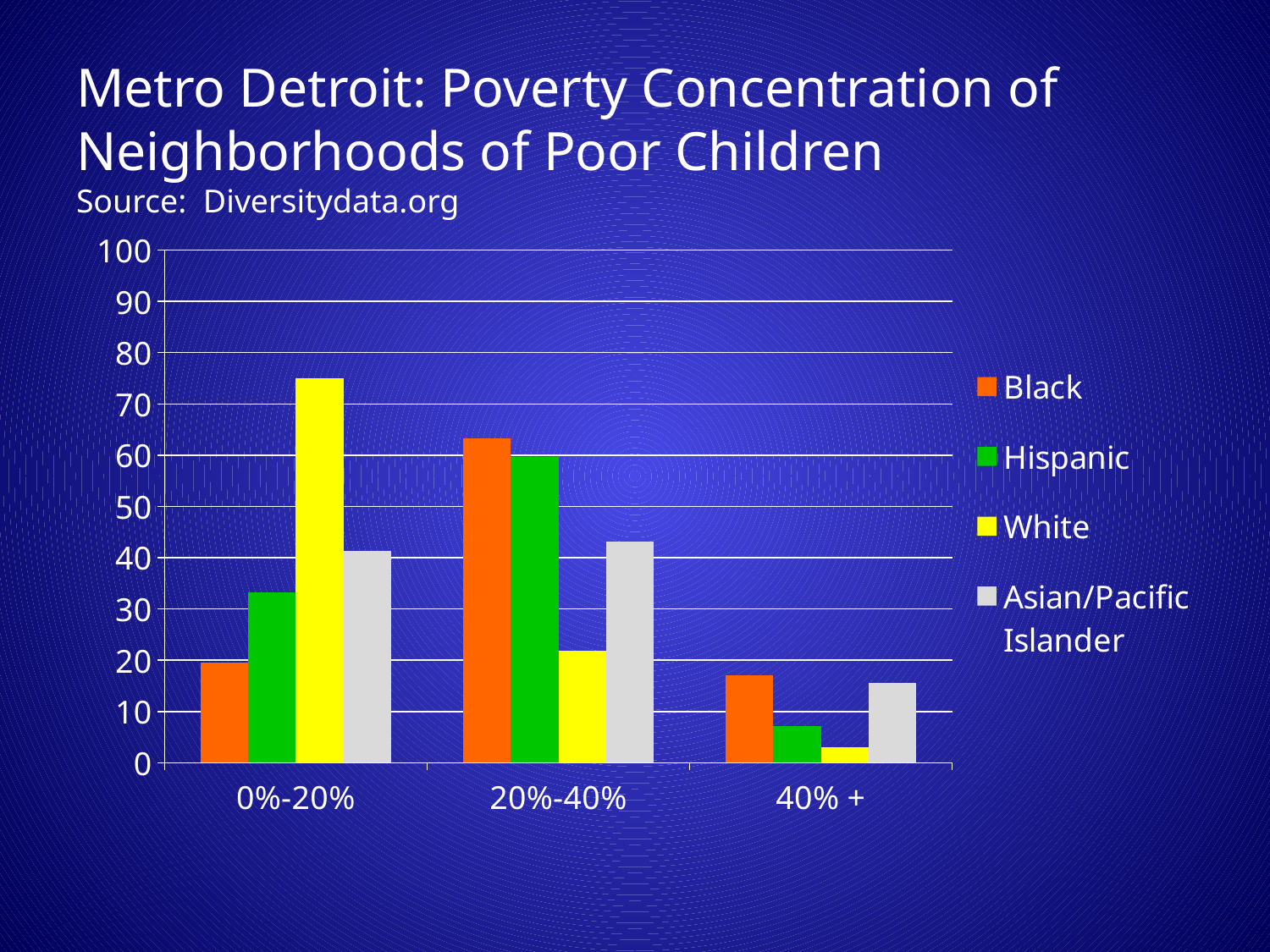
How many series does the legend list? 4 In the 0%-20% category, which group has the highest bar? White In the 40% + category, which group has the lowest bar? White How many poverty concentration categories are shown on the x axis? 3 What kind of chart is shown on the slide? Bar chart Is the value for Black in the 20%-40% category greater or less than 50? greater Is the value for White in the 0%-20% category greater or less than 70? greater In which category is the Black bar highest? 20%-40% Do the White values rise or fall moving from 0%-20% to 40% + along the x axis? fall Is the value for Hispanic in the 40% + category greater or less than 10? less What colour represents Hispanic in the legend? Green In the 0%-20% category, which is larger: the Hispanic bar or the Black bar? Hispanic